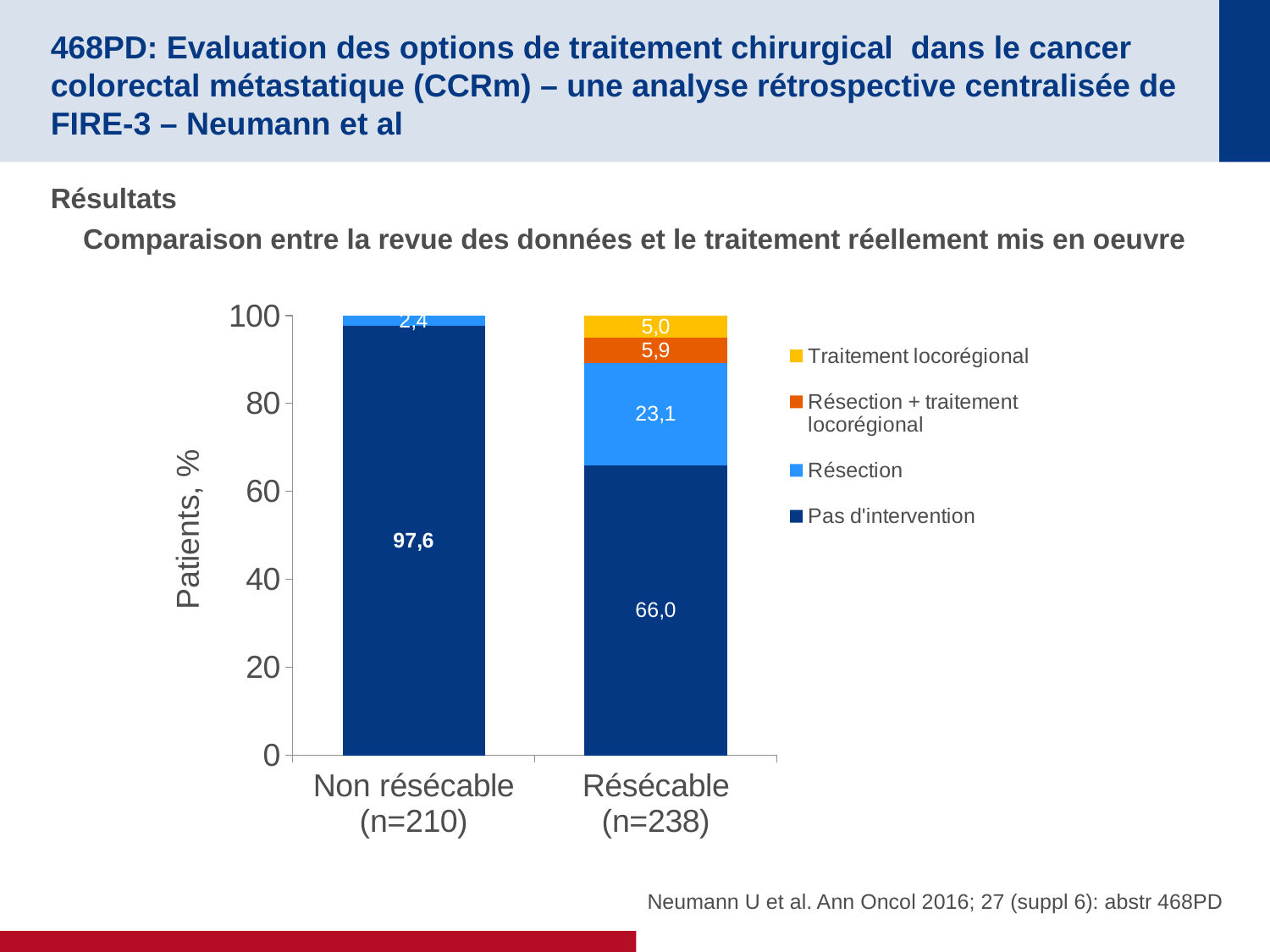
What is the label of the y axis? Patients, % How many series does the legend list? 4 What is the difference between the Pas d'intervention values for the Non résécable and Résécable groups? 31,6 What is the total of the stacked bar for the Résécable (n=238) group? 100,0 What is the value for Résection in the Non résécable (n=210) group? 2,4 What is the value for Traitement locorégional in the Résécable (n=238) group? 5,0 How many categories are shown on the x axis? 2 What is the value for Pas d'intervention in the Non résécable (n=210) group? 97,6 Which group has the larger Résection value, Non résécable or Résécable? Résécable What kind of chart is shown on the slide? Stacked bar chart What is the value for Résection + traitement locorégional in the Résécable (n=238) group? 5,9 What is the value for Résection in the Résécable (n=238) group? 23,1